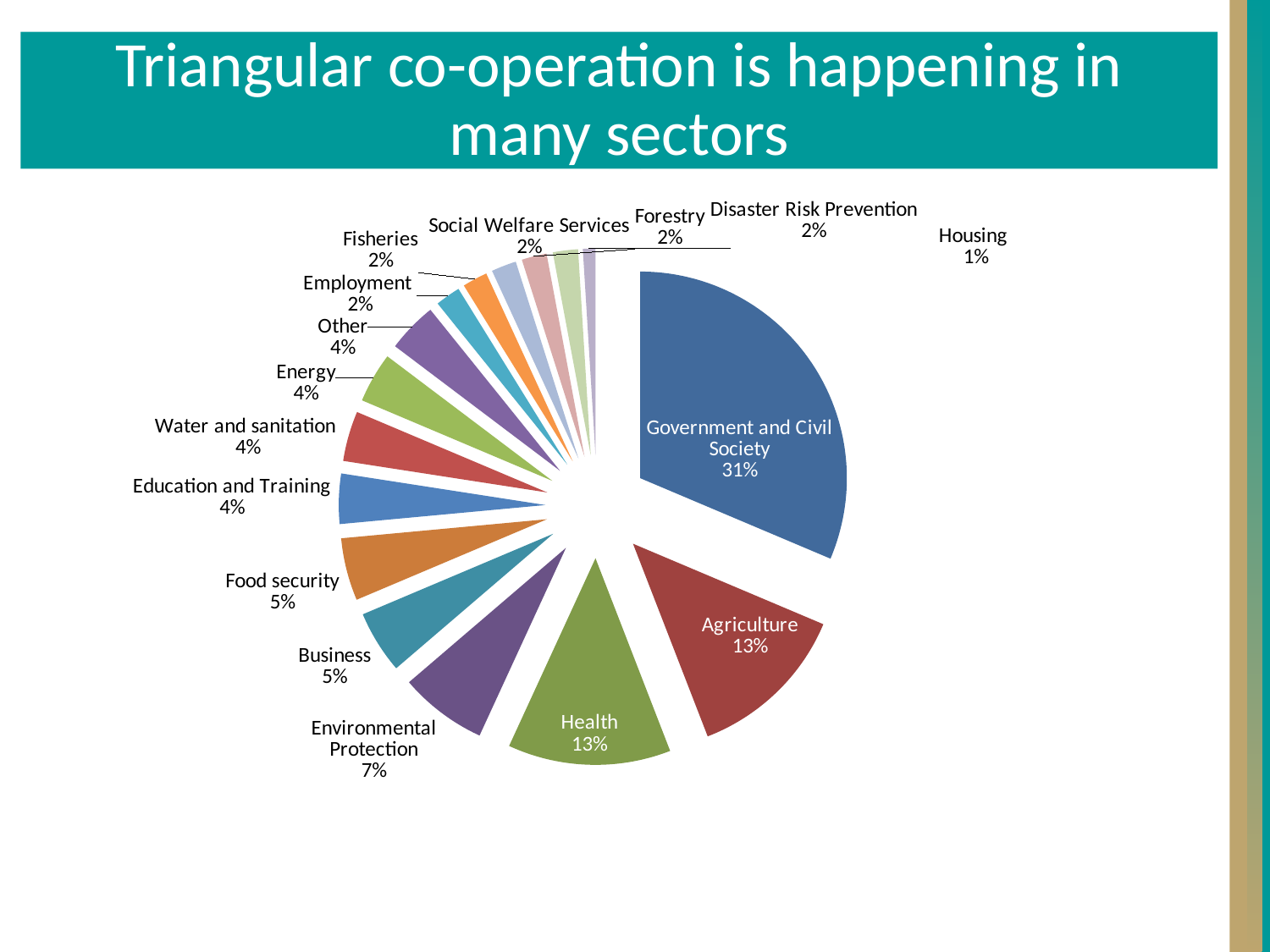
Which sector has the smallest slice of the pie? Housing What is the difference between the Government and Civil Society share and the Agriculture share? 18 percentage points What percentage is shown for Water and sanitation? 4% What is the title of the slide containing the chart? Triangular co-operation is happening in many sectors What is the difference between the Environmental Protection share and the Business share? 2 percentage points What percentage is shown for Food security? 5% What share of the pie does Government and Civil Society account for? 31% Which sector has the largest slice of the pie? Government and Civil Society What is the value shown for Environmental Protection? 7% How many sectors are shown in the pie chart? 16 Which is larger, the share for Health or the share for Environmental Protection? Health What kind of chart is shown on the slide? Pie chart